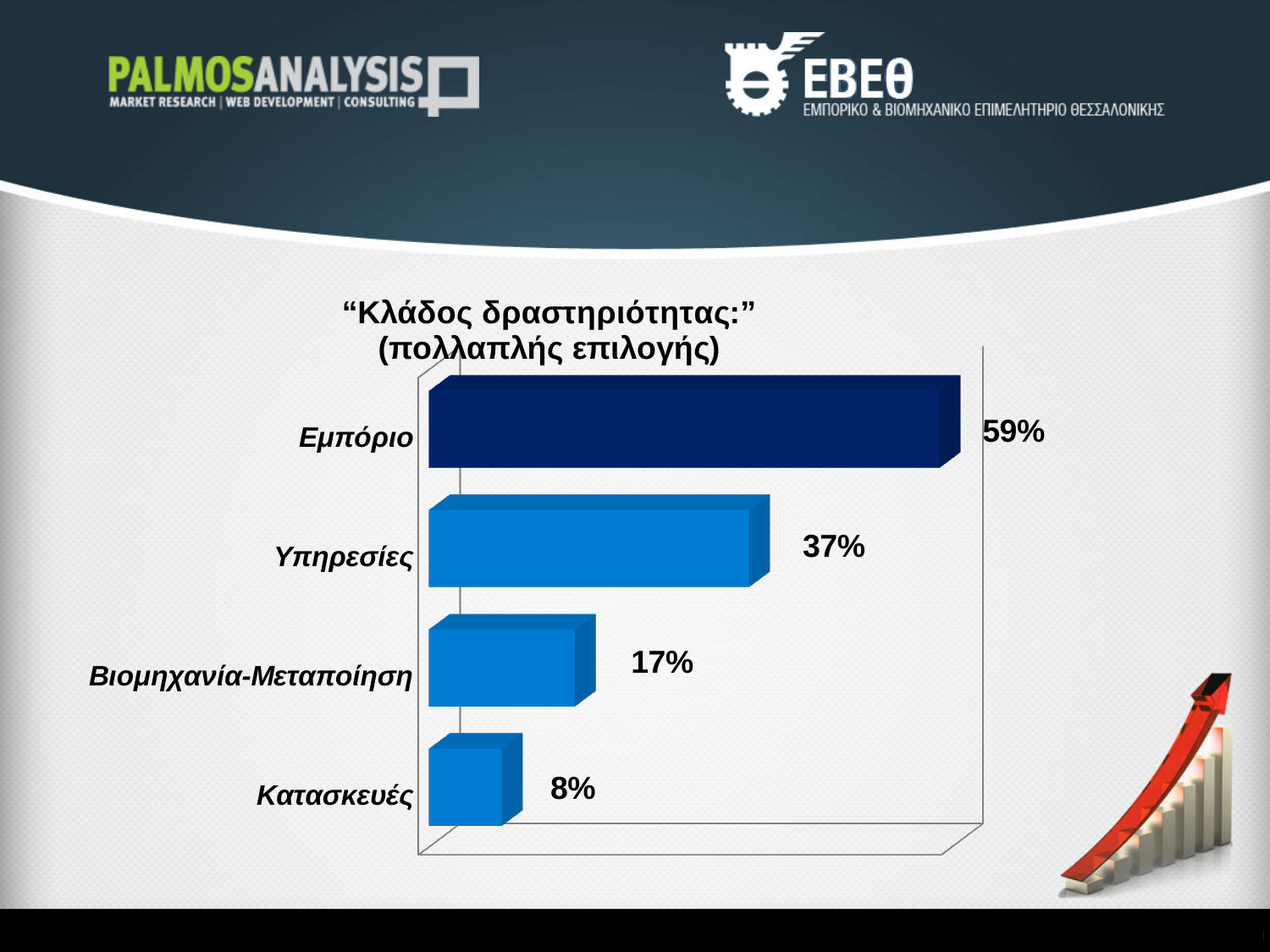
What is the value for Κατασκευές? 8% How many categories are shown in the chart? 4 What is the difference between the values for Εμπόριο and Υπηρεσίες? 22% Which category has the highest value? Εμπόριο What is the title of the chart? "Κλάδος δραστηριότητας:" (πολλαπλής επιλογής) What kind of chart is shown on the slide? Bar chart What is the value for Εμπόριο? 59% What is the difference between the values for Βιομηχανία-Μεταποίηση and Κατασκευές? 9% Which category has the lowest value? Κατασκευές Which is larger, the value for Υπηρεσίες or the value for Βιομηχανία-Μεταποίηση? Υπηρεσίες What is the value for Υπηρεσίες? 37% What is the value for Βιομηχανία-Μεταποίηση? 17%